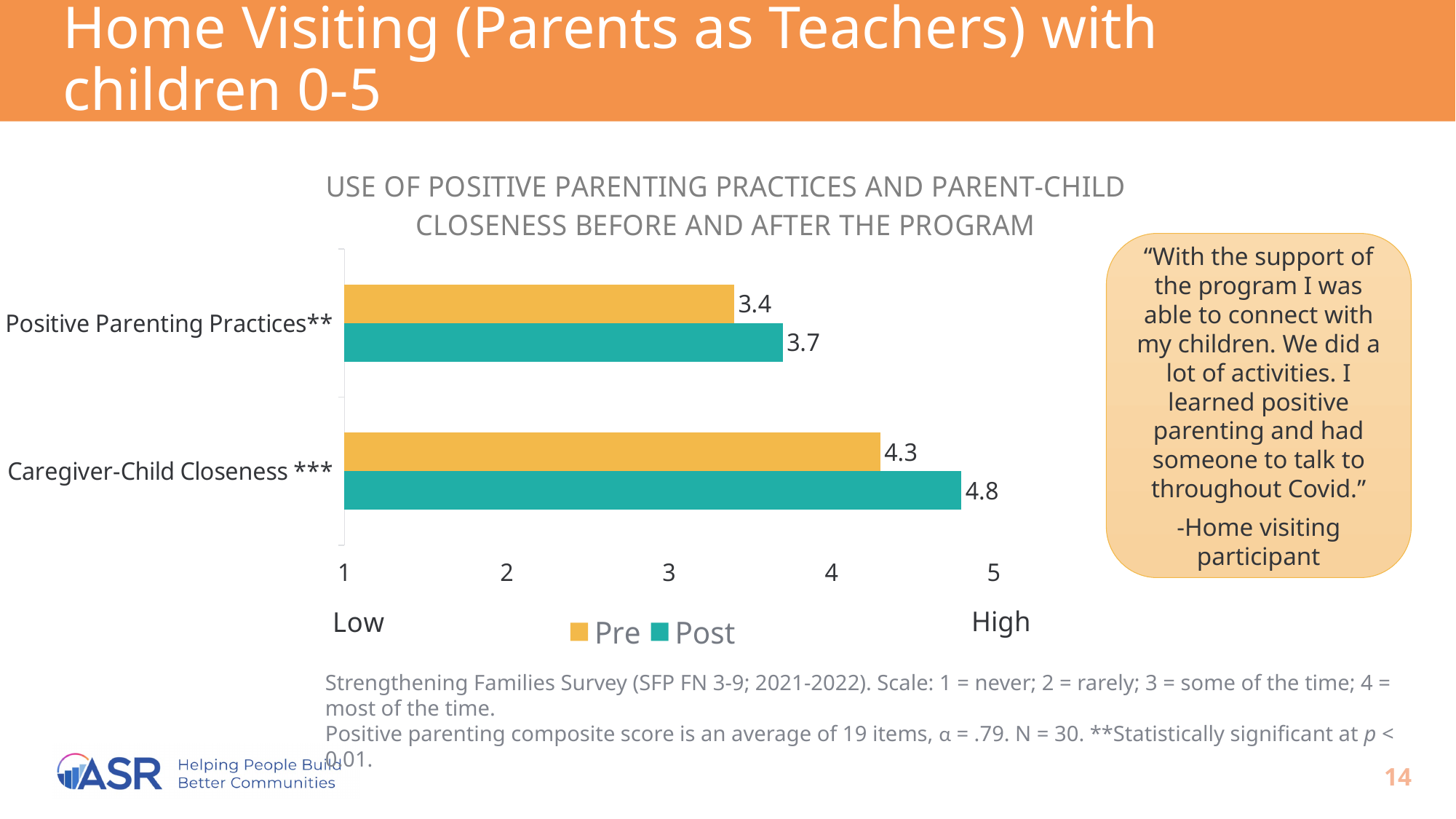
Which category has the lowest Pre value? Positive Parenting Practices** What is the Post value for Positive Parenting Practices**? 3.7 What is the Pre value for Caregiver-Child Closeness ***? 4.3 Which category has the highest Post value? Caregiver-Child Closeness *** What is the difference between the Post and Pre values for Caregiver-Child Closeness ***? 0.5 How many categories are shown on the chart? 2 What is the Post value for Caregiver-Child Closeness ***? 4.8 Which is larger for Positive Parenting Practices**, the Pre value or the Post value? Post What is the difference between the Post and Pre values for Positive Parenting Practices**? 0.3 How many series does the legend list? 2 What kind of chart is shown on the slide? Bar chart What is the Pre value for Positive Parenting Practices**? 3.4